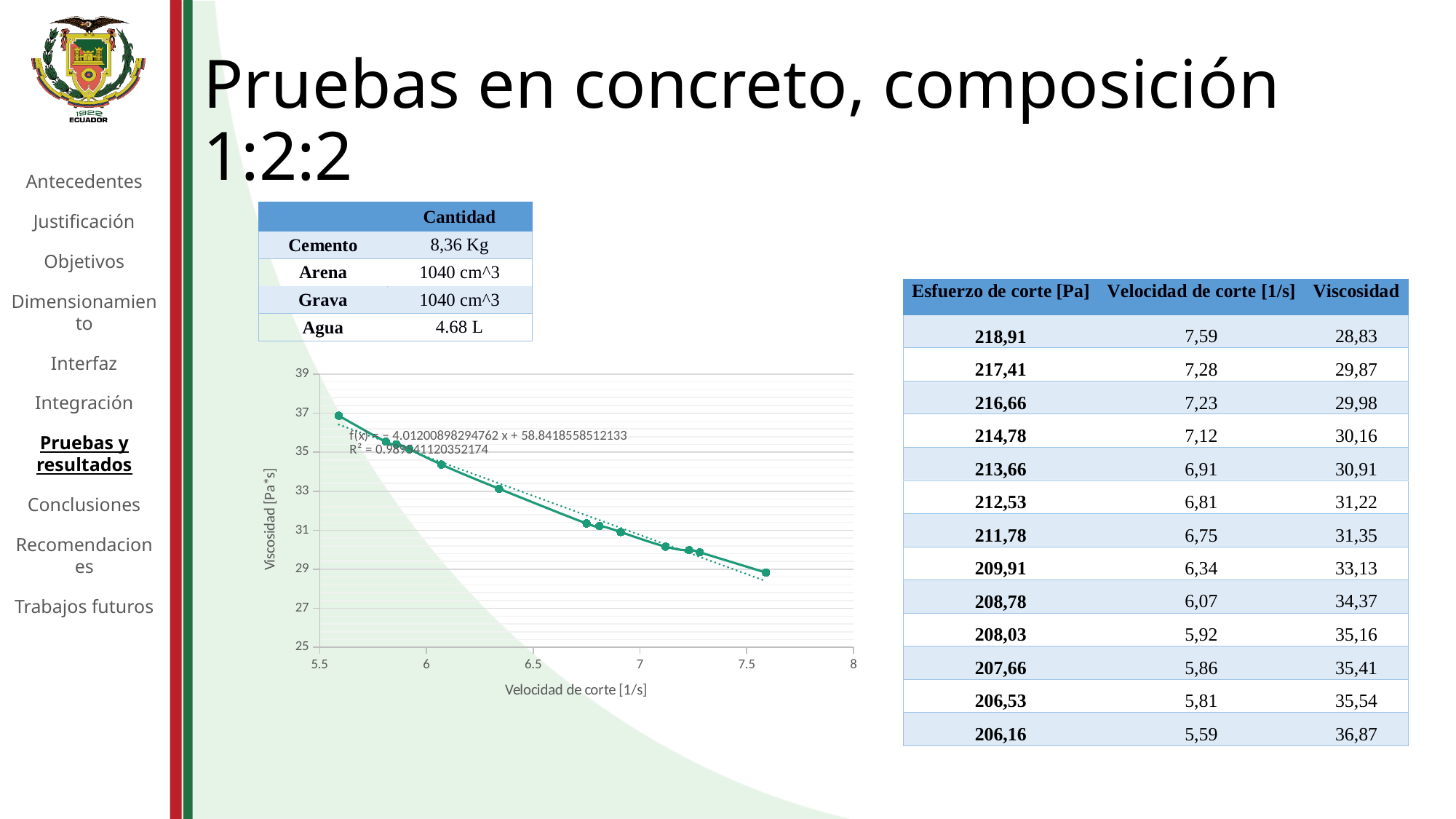
Is the viscosity value at a shear rate of 6.34 1/s greater or less than 35? less At which shear rate (Velocidad de corte) is the plotted viscosity lowest? 7,59 Which has the larger viscosity: the point at shear rate 6.07 or the point at shear rate 6.91? 6.07 At which shear rate (Velocidad de corte) is the plotted viscosity highest? 5,59 Is the viscosity value at a shear rate of 7.59 1/s greater or less than 29? less What is the label of the chart's x axis? Velocidad de corte [1/s] Is the viscosity value at a shear rate of 7.12 1/s greater or less than 29? greater Does the viscosity rise or fall as the shear rate (Velocidad de corte) increases along the x axis? fall What kind of chart is shown on the slide? scatter chart with a trendline How many data points are plotted on the chart? 13 What is the label of the chart's y axis? Viscosidad [Pa*s]